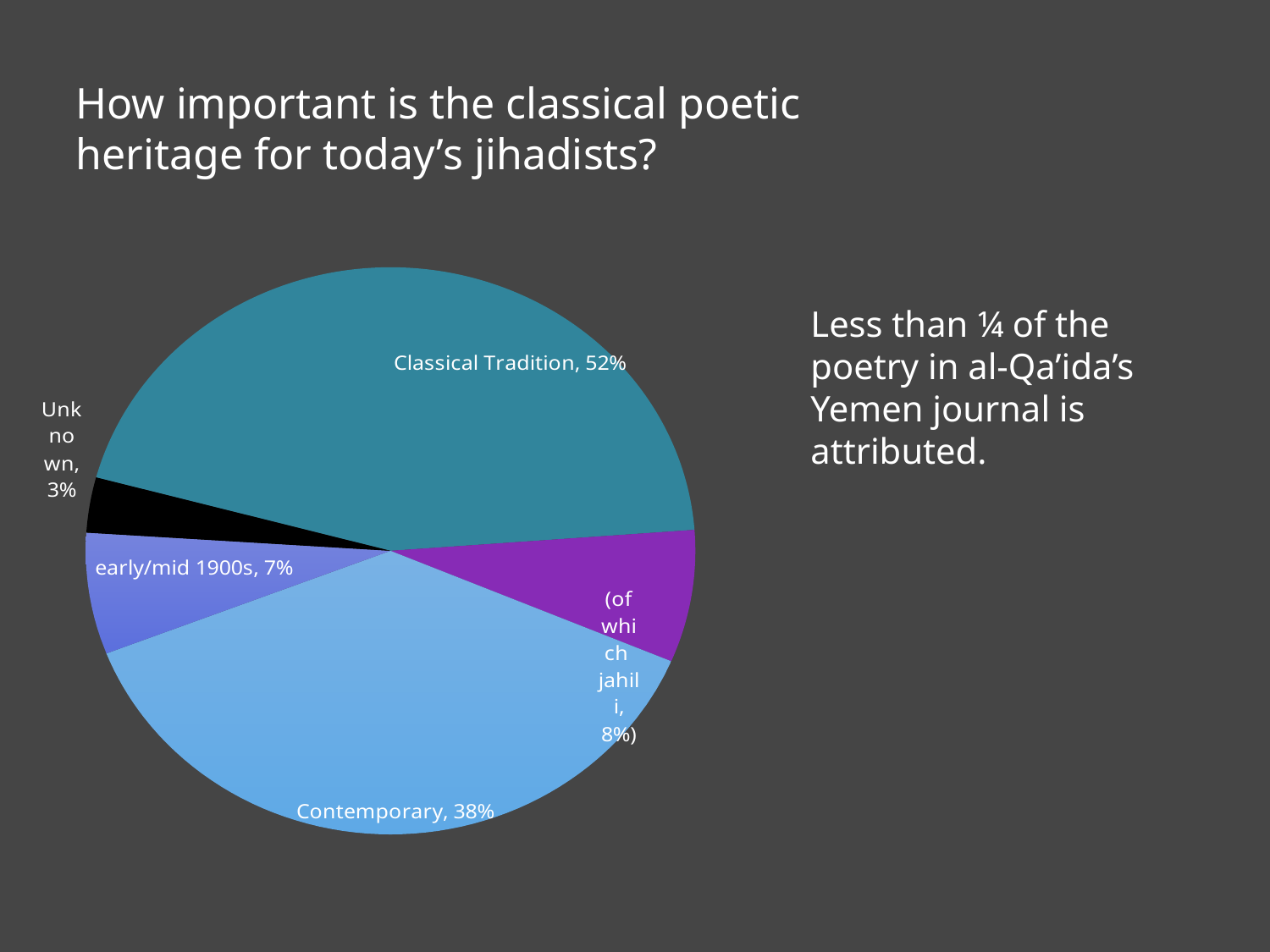
What is the difference in percentage points between Classical Tradition and Contemporary? 14 Which is larger, the early/mid 1900s slice or the Unknown slice? early/mid 1900s What kind of chart is shown on the slide? pie chart Which slice of the pie is the smallest? Unknown What percentage is shown for Classical Tradition? 52% What percentage is shown for Contemporary? 38% How many labelled slices does the pie chart have? 5 What percentage is shown for the slice labelled '(of which jahili)'? 8% What percentage is shown for early/mid 1900s? 7% What percentage is shown for Unknown? 3% What colour is the Unknown slice? black Which slice of the pie is the largest? Classical Tradition